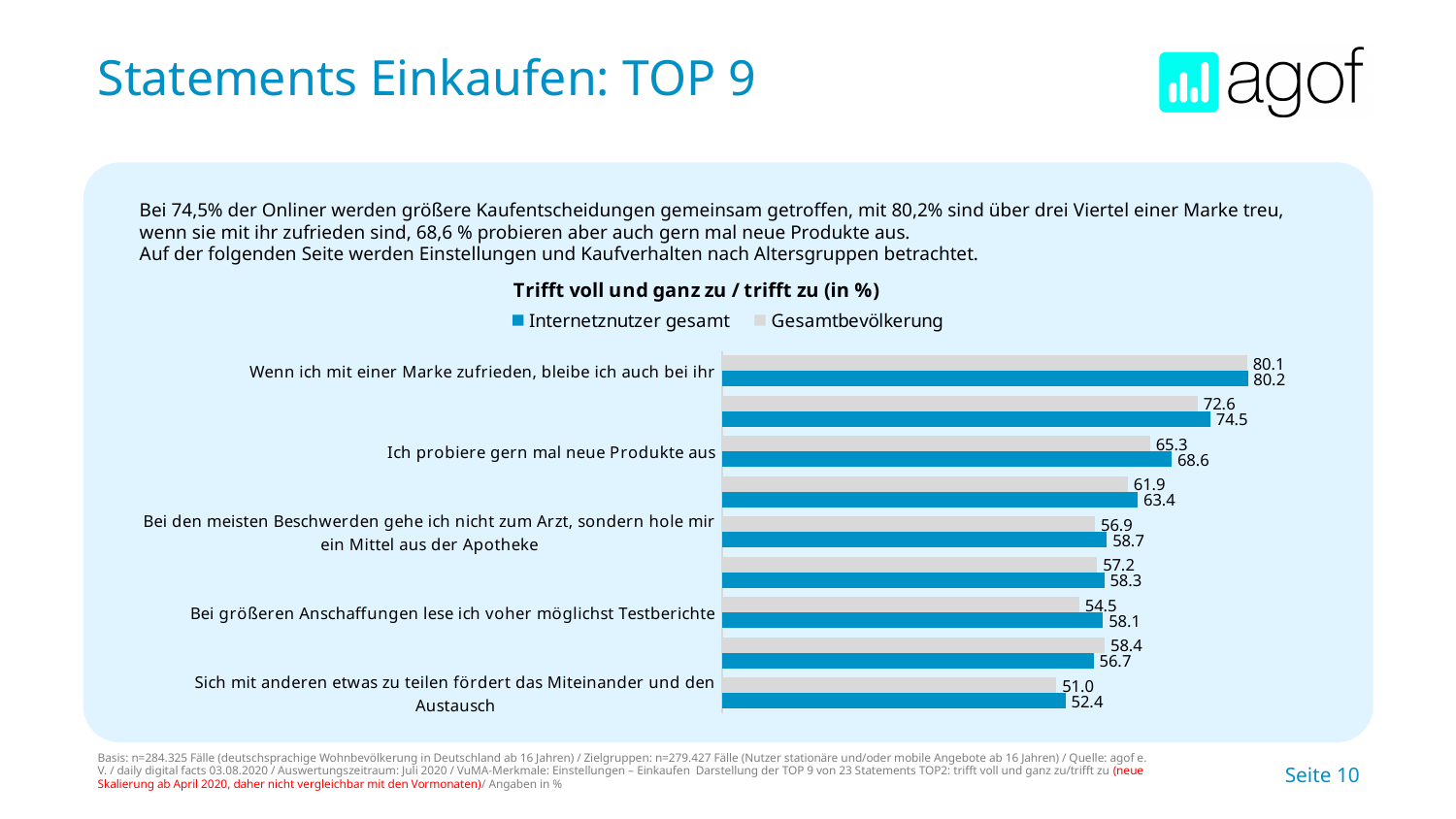
What kind of chart is shown on the slide? Bar chart What is the value for Gesamtbevölkerung for the statement "Sich mit anderen etwas zu teilen fördert das Miteinander und den Austausch"? 51.0 What is the value for Internetznutzer gesamt for the statement "Bei größeren Anschaffungen lese ich voher möglichst Testberichte"? 58.1 How many series does the chart legend list? 2 Which statement has the lowest value for Gesamtbevölkerung? Sich mit anderen etwas zu teilen fördert das Miteinander und den Austausch Which colour represents Gesamtbevölkerung in the chart? Grey Which statement has the highest value for Internetznutzer gesamt? Wenn ich mit einer Marke zufrieden, bleibe ich auch bei ihr For the statement "Ich probiere gern mal neue Produkte aus", which series has the larger value, Internetznutzer gesamt or Gesamtbevölkerung? Internetznutzer gesamt For the statement "Bei größeren Anschaffungen lese ich voher möglichst Testberichte", how much higher is the Internetznutzer gesamt value than the Gesamtbevölkerung value? 3.6 How many statements (categories) are plotted in the chart? 9 What is the value for Gesamtbevölkerung for the statement "Ich probiere gern mal neue Produkte aus"? 65.3 What is the value for Internetznutzer gesamt for the statement "Wenn ich mit einer Marke zufrieden, bleibe ich auch bei ihr"? 80.2